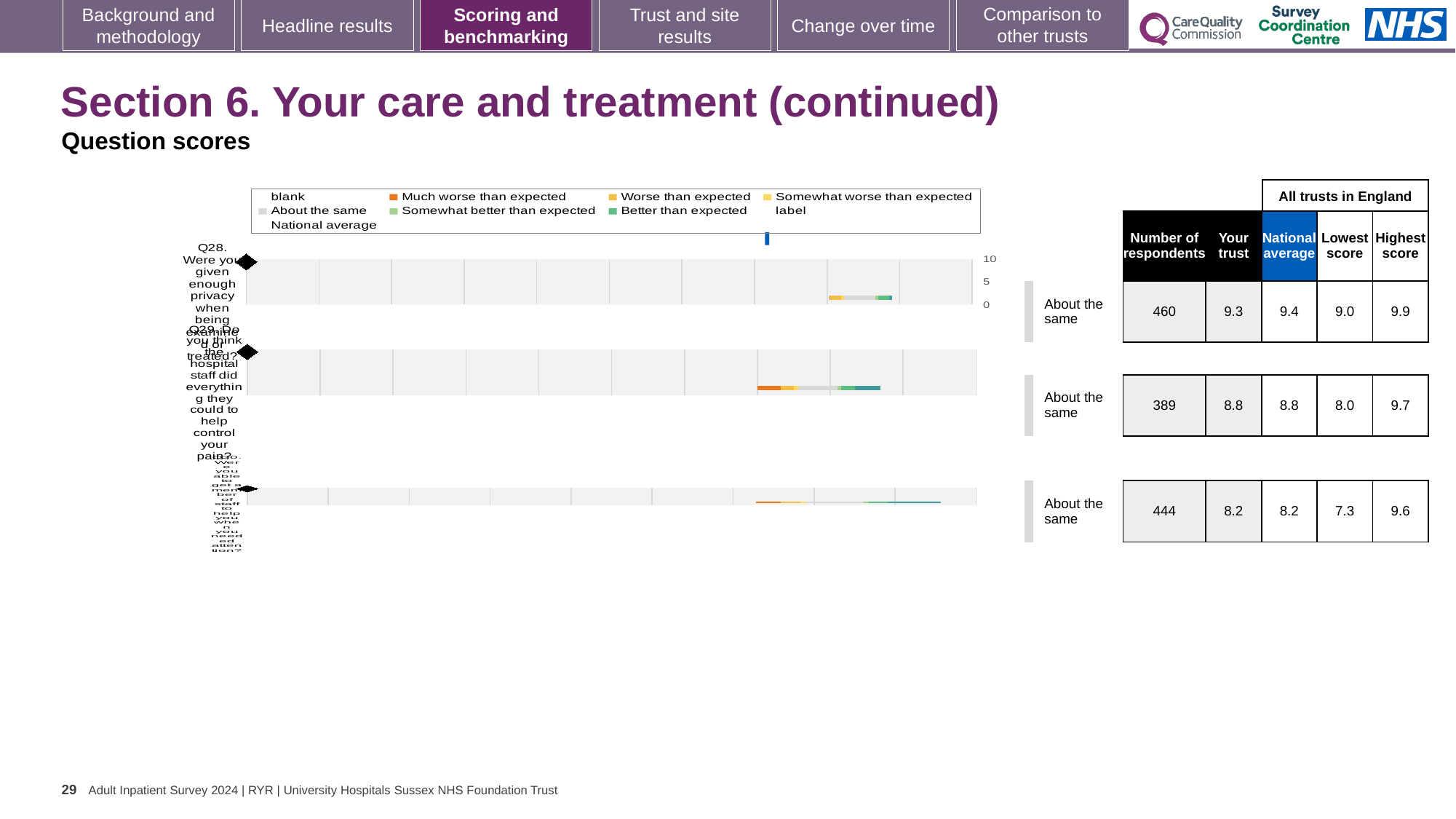
Which question has the highest 'Your trust' score? Q28 For Q28, which is larger: the 'Your trust' score or the national average? National average Which question has the lowest 'Your trust' score? Q30 What benchmark category is shown for Q29? About the same For Q28, what is the difference between the highest score and the lowest score across all trusts in England? 0.9 What is the 'Your trust' score for Q28 (privacy when being examined or treated)? 9.3 How many respondents answered Q30? 444 What kind of chart is used to show the question scores on this slide? bar chart Which colour in the legend represents 'Much worse than expected'? Orange How many survey questions are plotted in the chart? 3 What is the national average score for Q29 (staff did everything to help control your pain)? 8.8 What is the lowest score across all trusts in England for Q30? 7.3